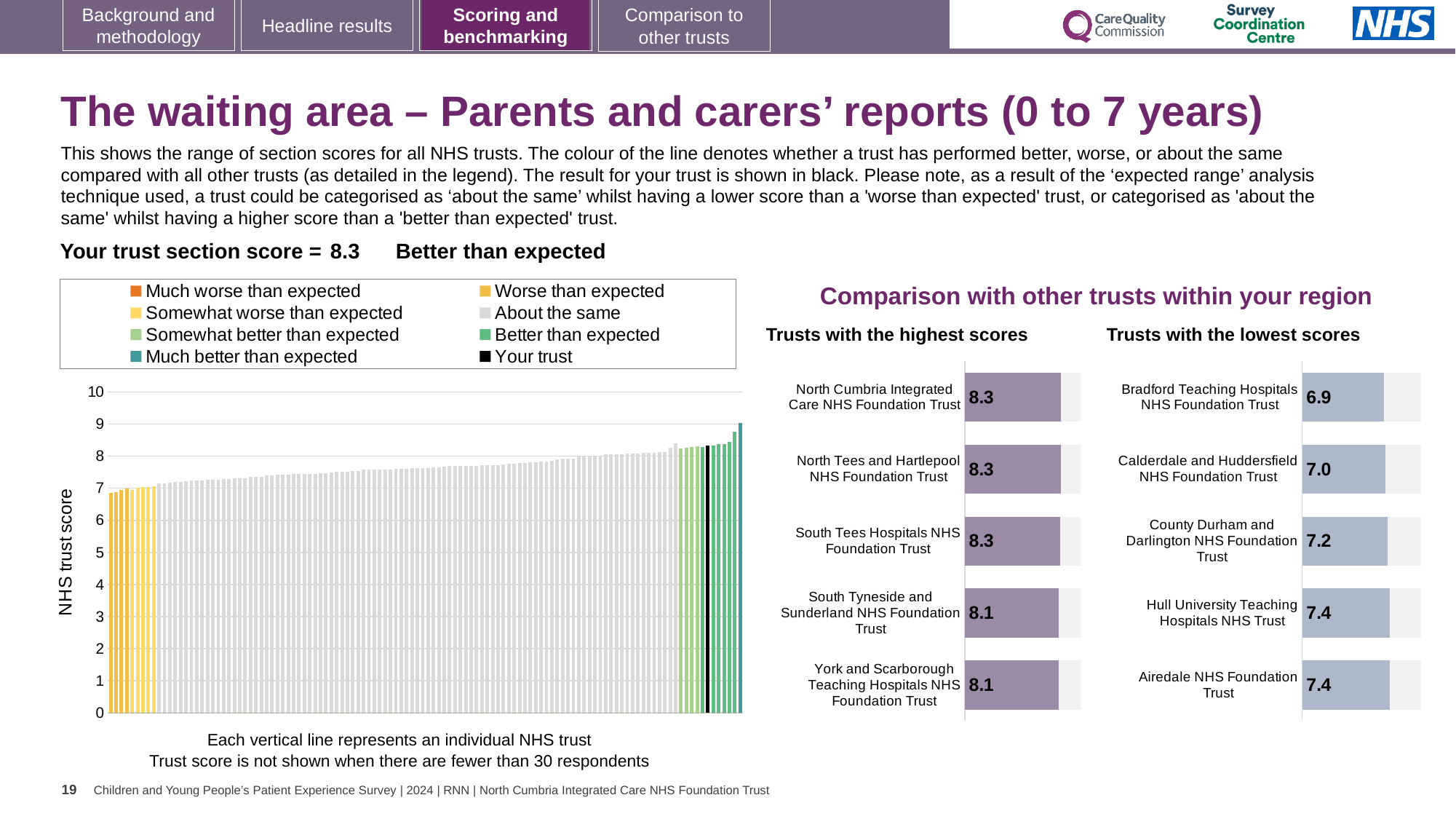
In the main chart on the left, do the trust scores rise or fall from left to right? Rise In the 'Trusts with the lowest scores' chart, what is the difference between the scores of Hull University Teaching Hospitals NHS Trust and Bradford Teaching Hospitals NHS Foundation Trust? 0.5 In the main chart on the left, is the value of the black 'Your trust' bar greater or less than 8? greater In the 'Trusts with the lowest scores' chart, which trust has the lowest score? Bradford Teaching Hospitals NHS Foundation Trust In the 'Trusts with the lowest scores' chart, what is the difference between the scores of Airedale NHS Foundation Trust and Calderdale and Huddersfield NHS Foundation Trust? 0.4 How many entries does the legend of the main NHS trust score chart on the left list? 8 What is the label on the vertical axis of the main chart on the left? NHS trust score In the 'Trusts with the lowest scores' chart, what is the score for County Durham and Darlington NHS Foundation Trust? 7.2 How many trusts are shown in the 'Trusts with the highest scores' chart? 5 In the 'Trusts with the highest scores' chart, which has the higher score: North Tees and Hartlepool NHS Foundation Trust or York and Scarborough Teaching Hospitals NHS Foundation Trust? North Tees and Hartlepool NHS Foundation Trust In the 'Trusts with the highest scores' chart, what is the score for South Tyneside and Sunderland NHS Foundation Trust? 8.1 What kind of chart is the main chart on the left showing NHS trust scores? Bar chart